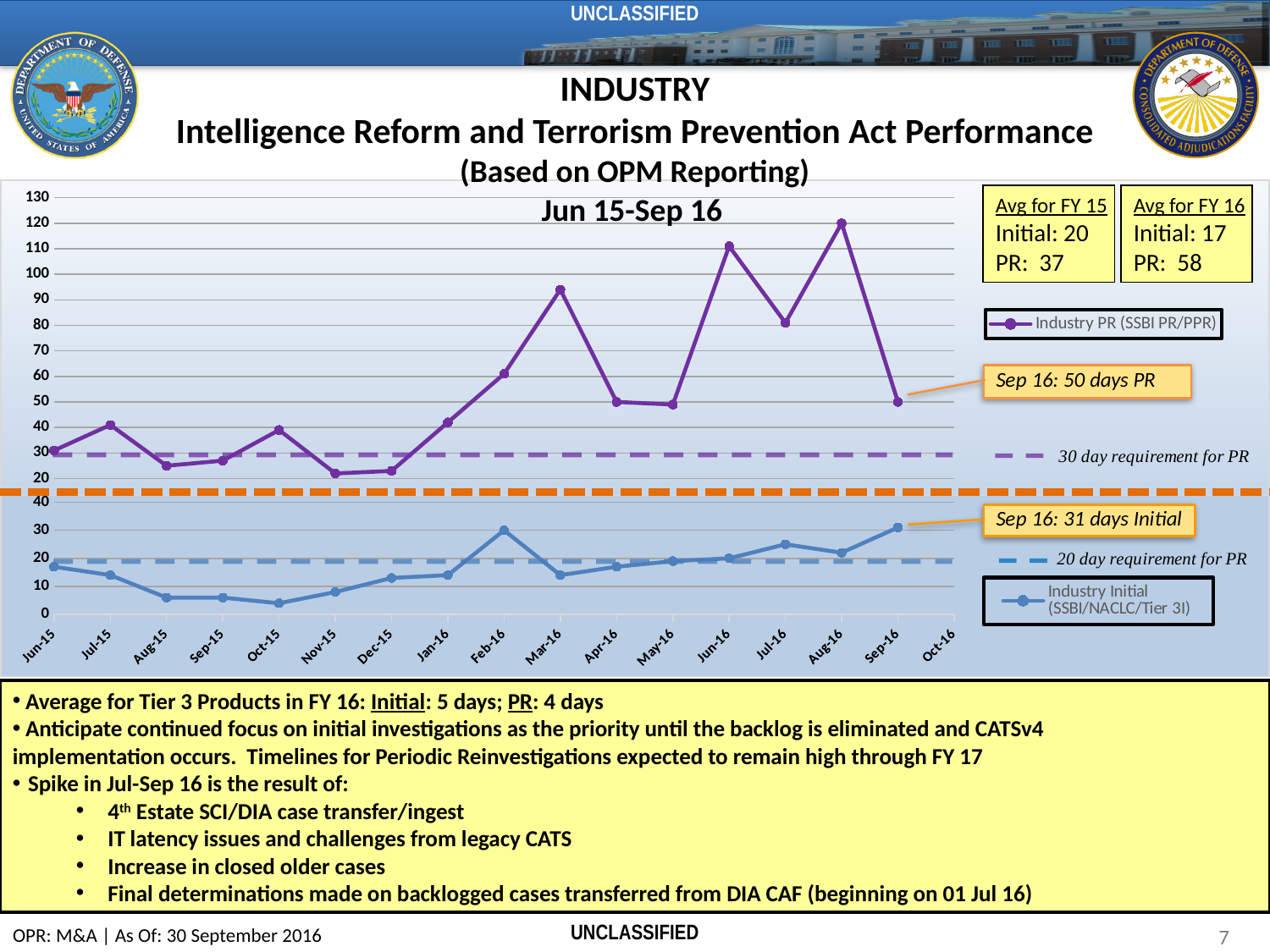
What is the Industry PR value for Sep 16 according to the callout on the chart? 50 days Does the Industry PR line rise or fall from Dec-15 to Mar-16? rise Is the Industry PR value for Jul-16 greater or less than 70? greater What is the title of the chart? Jun 15-Sep 16 Is the Industry PR value for Nov-15 greater or less than 30? less Is the Industry Initial value for Oct-15 greater or less than 10? less What kind of chart is shown on the slide? line chart Which is larger, the Industry PR value for Jul-16 or for Aug-16? Aug-16 What is the Industry Initial value for Sep 16 according to the callout on the chart? 31 days Which is larger, the Industry Initial value for Feb-16 or for Mar-16? Feb-16 In which month does the Industry PR (SSBI PR/PPR) line reach its highest value? Aug-16